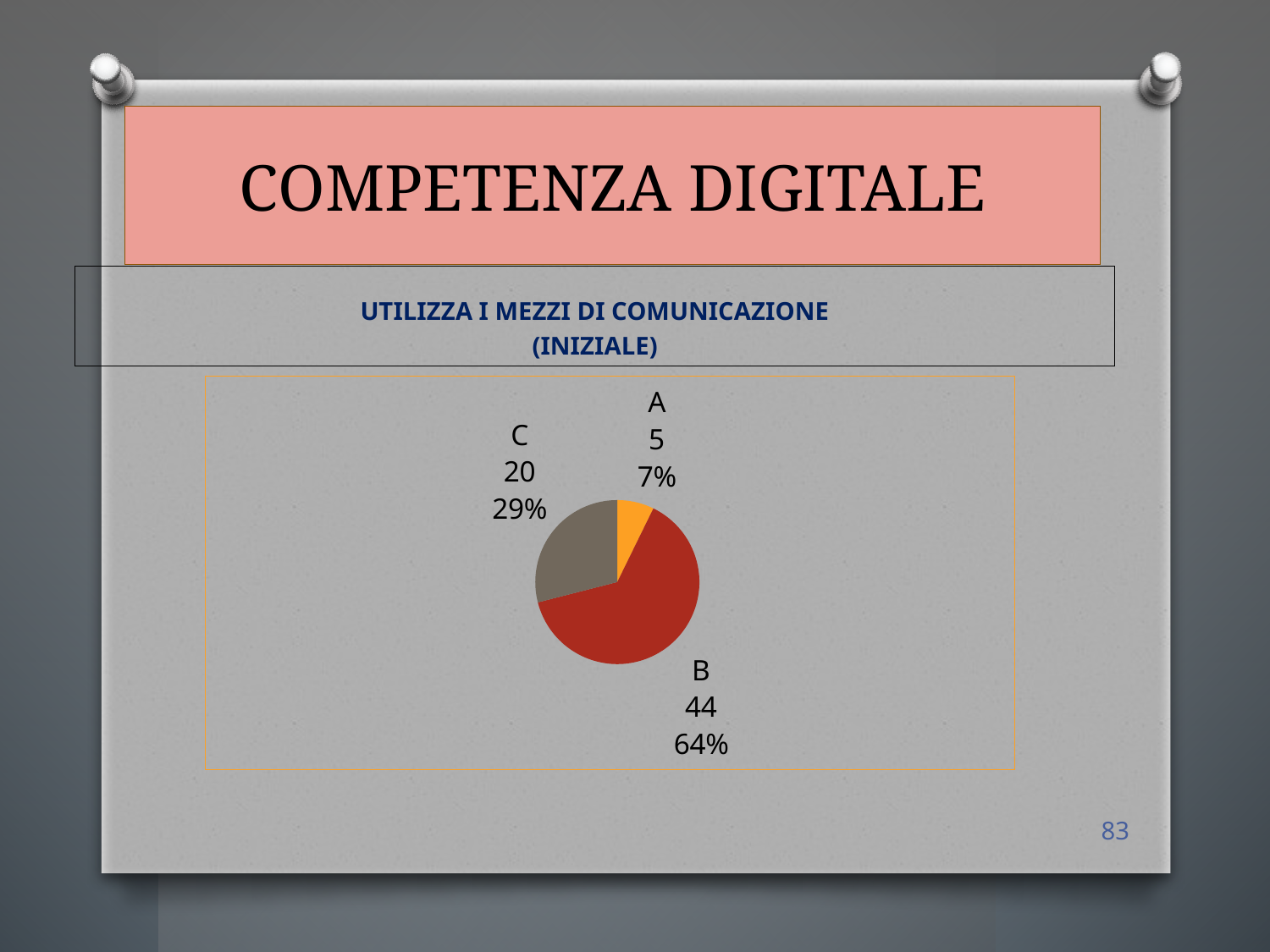
What percentage share does category B have? 64% What percentage share does category C have? 29% What is the value for category C? 20 What is the value for category B? 44 What is the difference between the values for B and C? 24 What is the title of the chart? UTILIZZA I MEZZI DI COMUNICAZIONE (INIZIALE) Which category has the largest slice? B What kind of chart is shown on the slide? pie chart How many categories are shown in the pie chart? 3 Which category has the smallest slice? A Which is larger, the value for C or the value for A? C What is the value for category A? 5